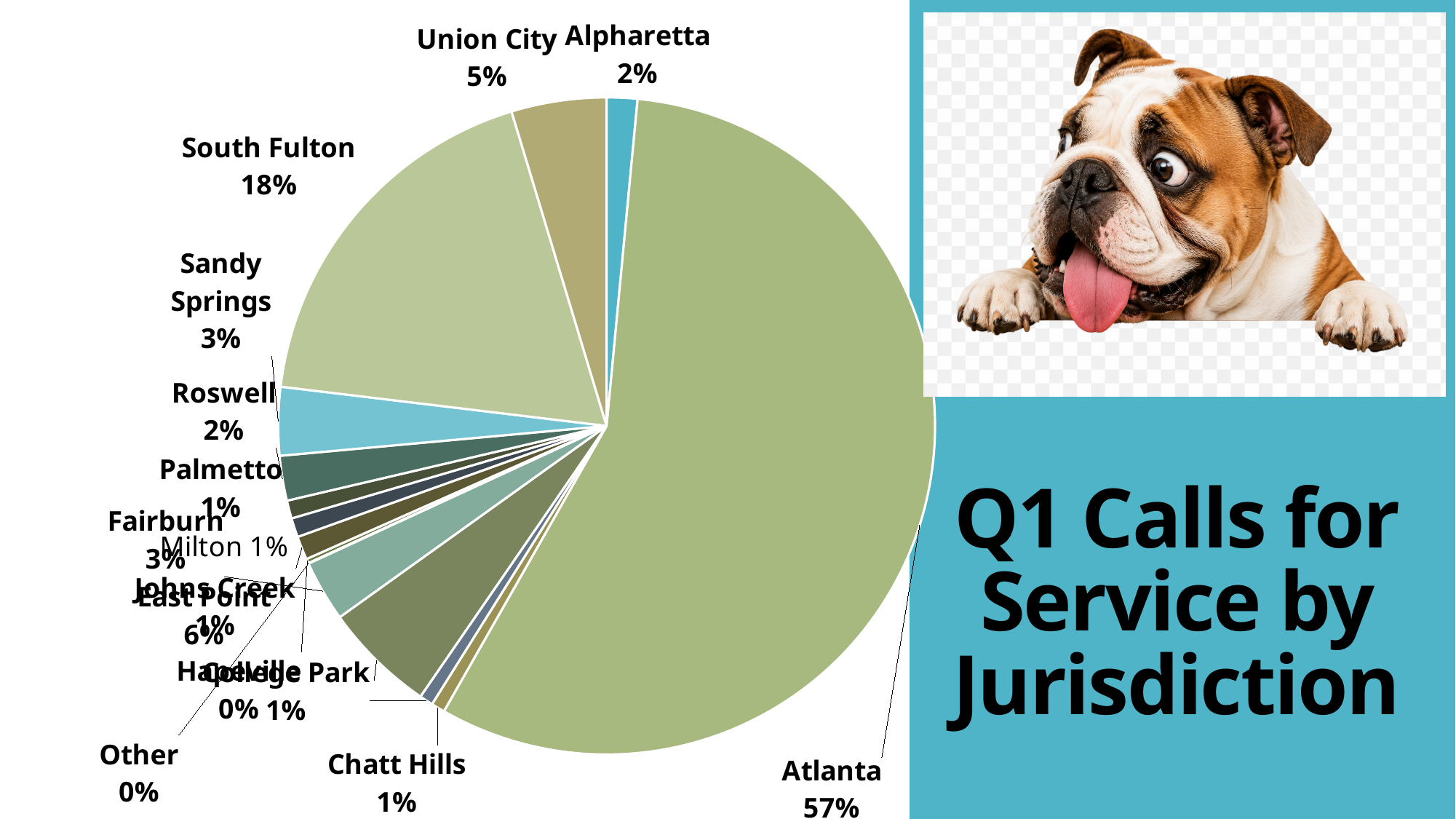
What share of Q1 calls for service does Atlanta account for? 57% Which jurisdiction has the largest share of calls for service? Atlanta What percentage is shown for South Fulton? 18% What is the difference in percentage points between Atlanta and South Fulton? 39% What percentage is shown for Union City? 5% Which has a larger share, Union City or Sandy Springs? Union City What is the difference in percentage points between South Fulton and Union City? 13% What is the title of the chart on the slide? Q1 Calls for Service by Jurisdiction What percentage is shown for Alpharetta? 2% What percentage is shown for Roswell? 2% What kind of chart is shown on the slide? pie chart What percentage is shown for Chatt Hills? 1%